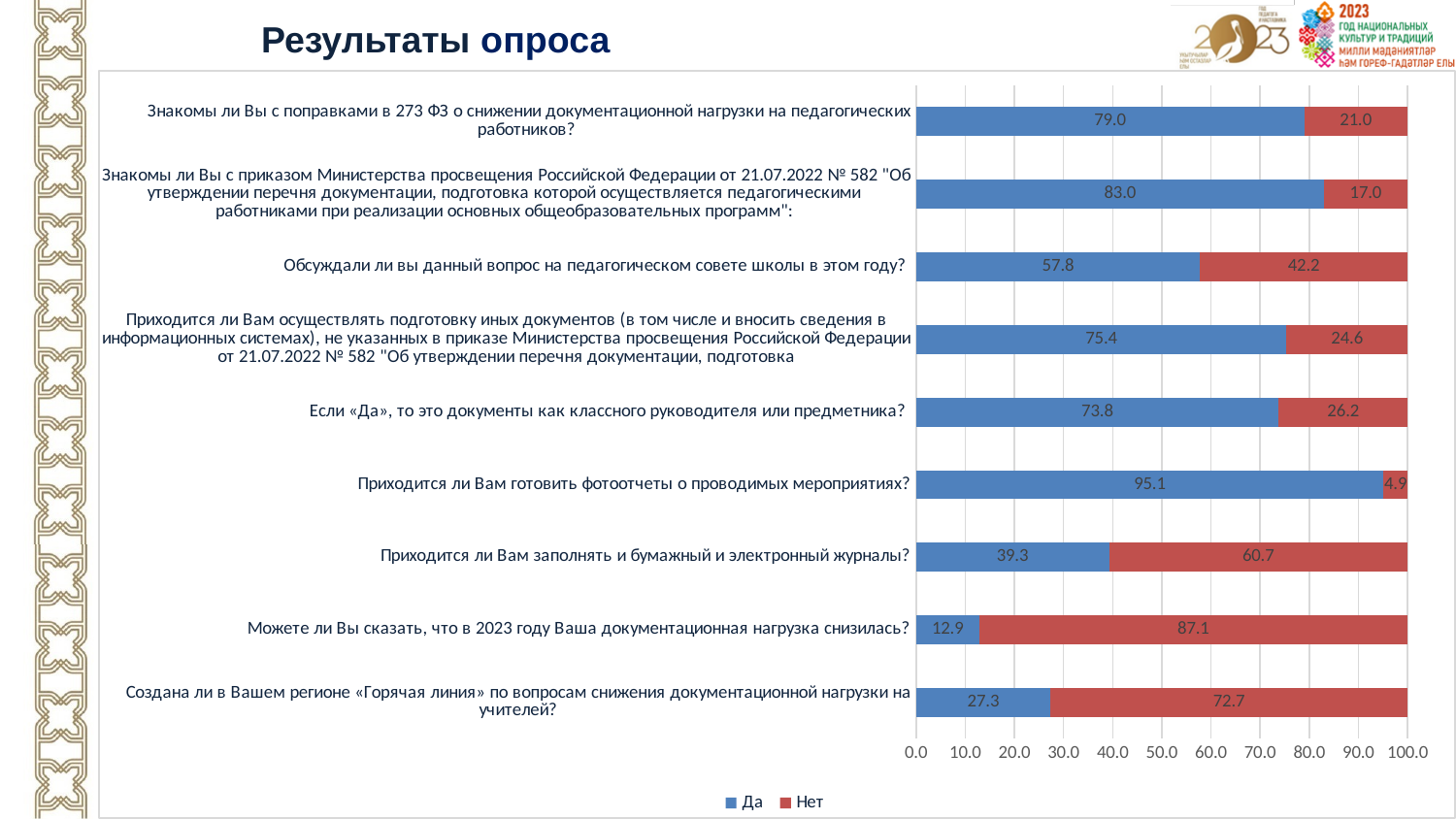
Which question has the highest "Да" value? Приходится ли Вам готовить фотоотчеты о проводимых мероприятиях? Which is larger: the "Да" value for "Знакомы ли Вы с поправками в 273 ФЗ о снижении документационной нагрузки на педагогических работников?" or the "Да" value for "Знакомы ли Вы с приказом Министерства просвещения Российской Федерации от 21.07.2022 № 582"? Знакомы ли Вы с приказом Министерства просвещения Российской Федерации от 21.07.2022 № 582 How many series does the legend list? 2 What is the "Да" value for "Обсуждали ли вы данный вопрос на педагогическом совете школы в этом году?"? 57.8 What is the "Нет" value for "Создана ли в Вашем регионе «Горячая линия» по вопросам снижения документационной нагрузки на учителей?"? 72.7 What type of chart is shown on the slide? Stacked bar chart What is the "Нет" value for "Можете ли Вы сказать, что в 2023 году Ваша документационная нагрузка снизилась?"? 87.1 What is the "Да" value for "Приходится ли Вам готовить фотоотчеты о проводимых мероприятиях?"? 95.1 Which question has the lowest "Да" value? Можете ли Вы сказать, что в 2023 году Ваша документационная нагрузка снизилась? What is the total of the stacked bar for "Если «Да», то это документы как классного руководителя или предметника?"? 100.0 How many survey questions (categories) are shown in the chart? 9 What is the difference between the "Да" and "Нет" values for "Приходится ли Вам заполнять и бумажный и электронный журналы?"? 21.4